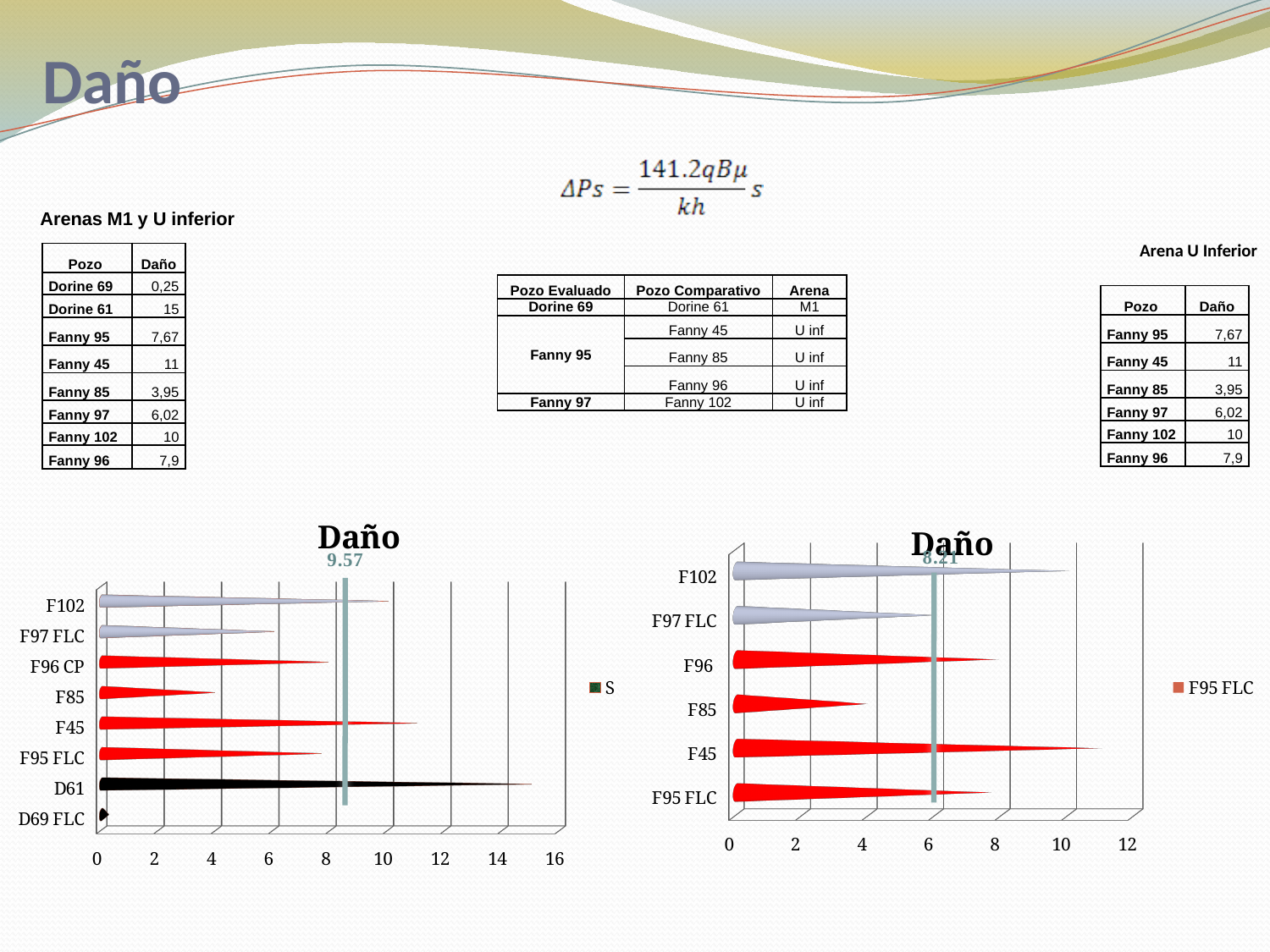
In the left 'Daño' chart, is the value for F85 greater or less than 6? less What value is labelled on the vertical reference line in the left 'Daño' chart? 9.57 In the left 'Daño' chart, which category has the highest value? D61 In the left 'Daño' chart, which is larger, the value for F45 or the value for F85? F45 In the right 'Daño' chart, is the value for F102 greater or less than 8? greater How many categories are shown on the left 'Daño' chart? 8 In the left 'Daño' chart, is the value for F45 greater or less than 8? greater What kind of chart is the left 'Daño' chart? bar chart In the right 'Daño' chart, which category has the lowest value? F85 In the left 'Daño' chart, which category has the lowest value? D69 FLC In the right 'Daño' chart, which category has the highest value? F45 How many categories are shown on the right 'Daño' chart? 6